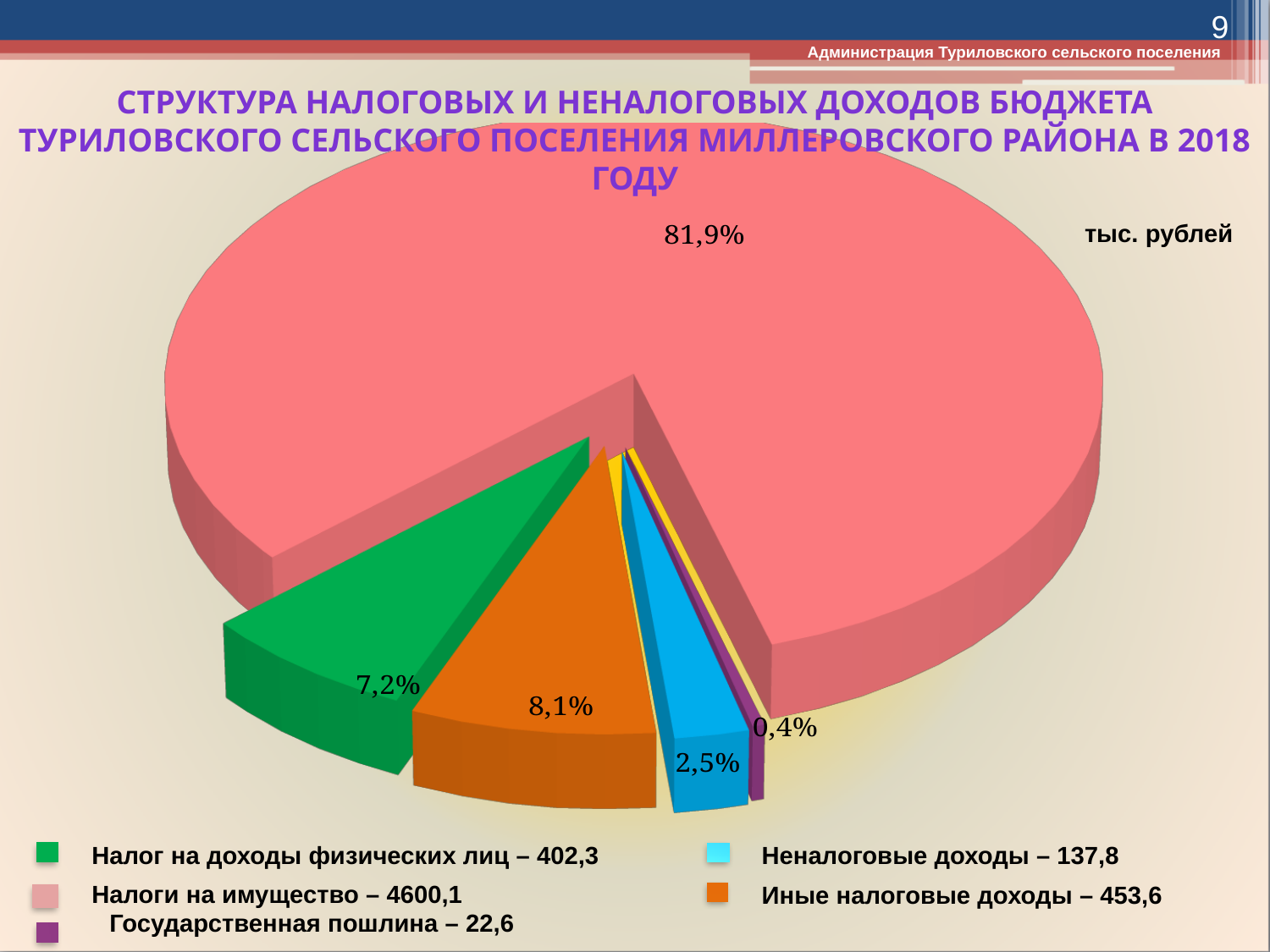
Which is larger: Иные налоговые доходы or Налог на доходы физических лиц? Иные налоговые доходы How many entries does the legend list? 5 What percentage share does the slice for Налоги на имущество have? 81,9% Which category has the largest share of the pie? Налоги на имущество What is the difference in тыс. рублей between Иные налоговые доходы (453,6) and Налог на доходы физических лиц (402,3)? 51,3 What value (тыс. рублей) does the legend give for Налоги на имущество? 4600,1 Which category has the smallest share of the pie? Государственная пошлина What percentage share does the slice for Неналоговые доходы have? 2,5% What value (тыс. рублей) does the legend give for Государственная пошлина? 22,6 What percentage share does the slice for Иные налоговые доходы have? 8,1% What type of chart is shown on the slide? pie chart